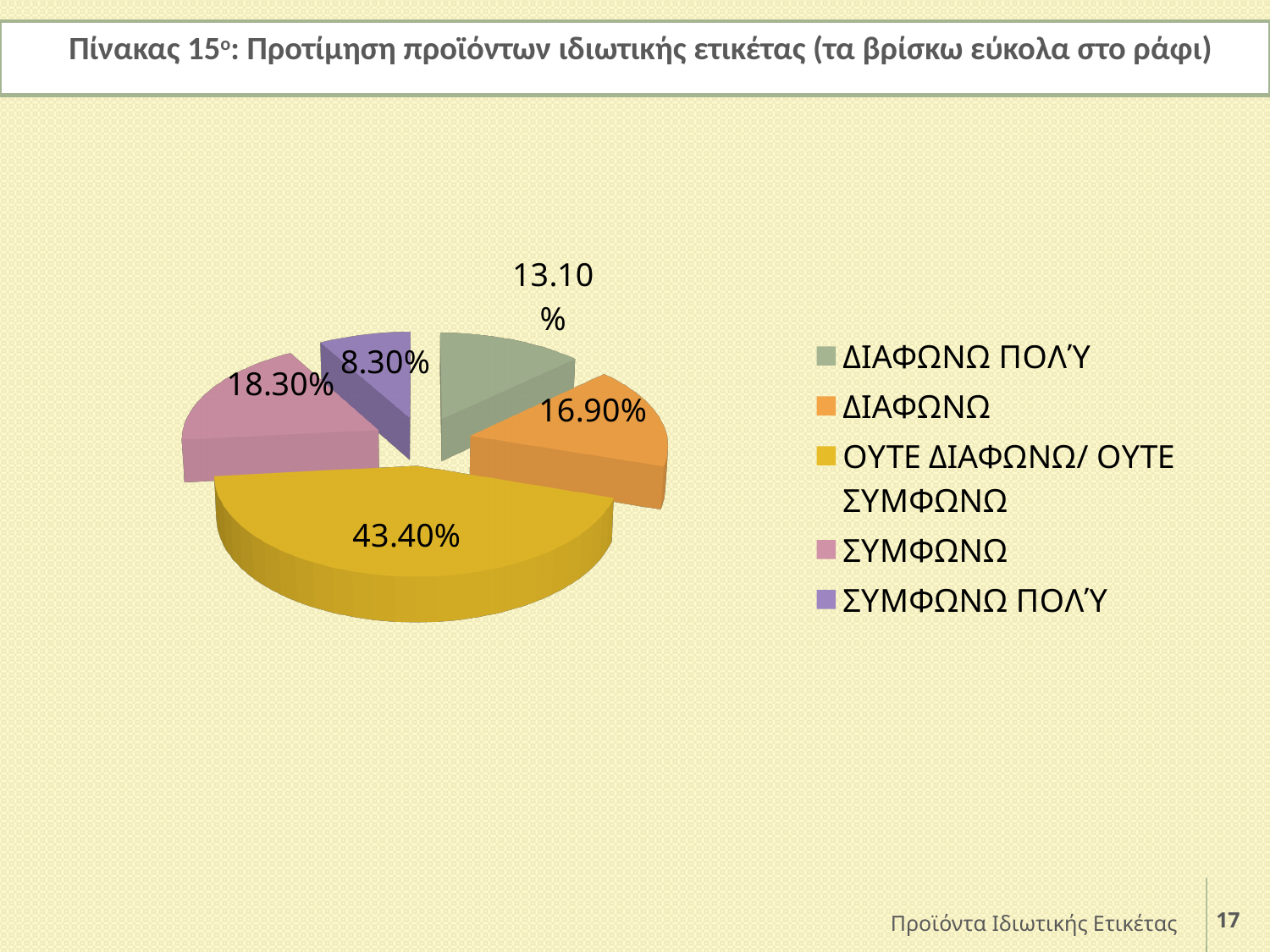
Which category has the largest share of the pie? ΟΥΤΕ ΔΙΑΦΩΝΩ/ ΟΥΤΕ ΣΥΜΦΩΝΩ What percentage is shown for ΔΙΑΦΩΝΩ ΠΟΛΎ? 13.10% How many categories does the legend list? 5 What kind of chart is shown on the slide? Pie chart What percentage is shown for ΔΙΑΦΩΝΩ? 16.90% What is the difference in percentage points between ΣΥΜΦΩΝΩ and ΔΙΑΦΩΝΩ? 1.40 Which is larger, the share for ΔΙΑΦΩΝΩ ΠΟΛΎ or the share for ΣΥΜΦΩΝΩ ΠΟΛΎ? ΔΙΑΦΩΝΩ ΠΟΛΎ What colour is the slice for ΟΥΤΕ ΔΙΑΦΩΝΩ/ ΟΥΤΕ ΣΥΜΦΩΝΩ? Yellow What percentage is shown for ΣΥΜΦΩΝΩ? 18.30% Which category has the smallest share of the pie? ΣΥΜΦΩΝΩ ΠΟΛΎ What percentage is shown for ΟΥΤΕ ΔΙΑΦΩΝΩ/ ΟΥΤΕ ΣΥΜΦΩΝΩ? 43.40% What percentage is shown for ΣΥΜΦΩΝΩ ΠΟΛΎ? 8.30%